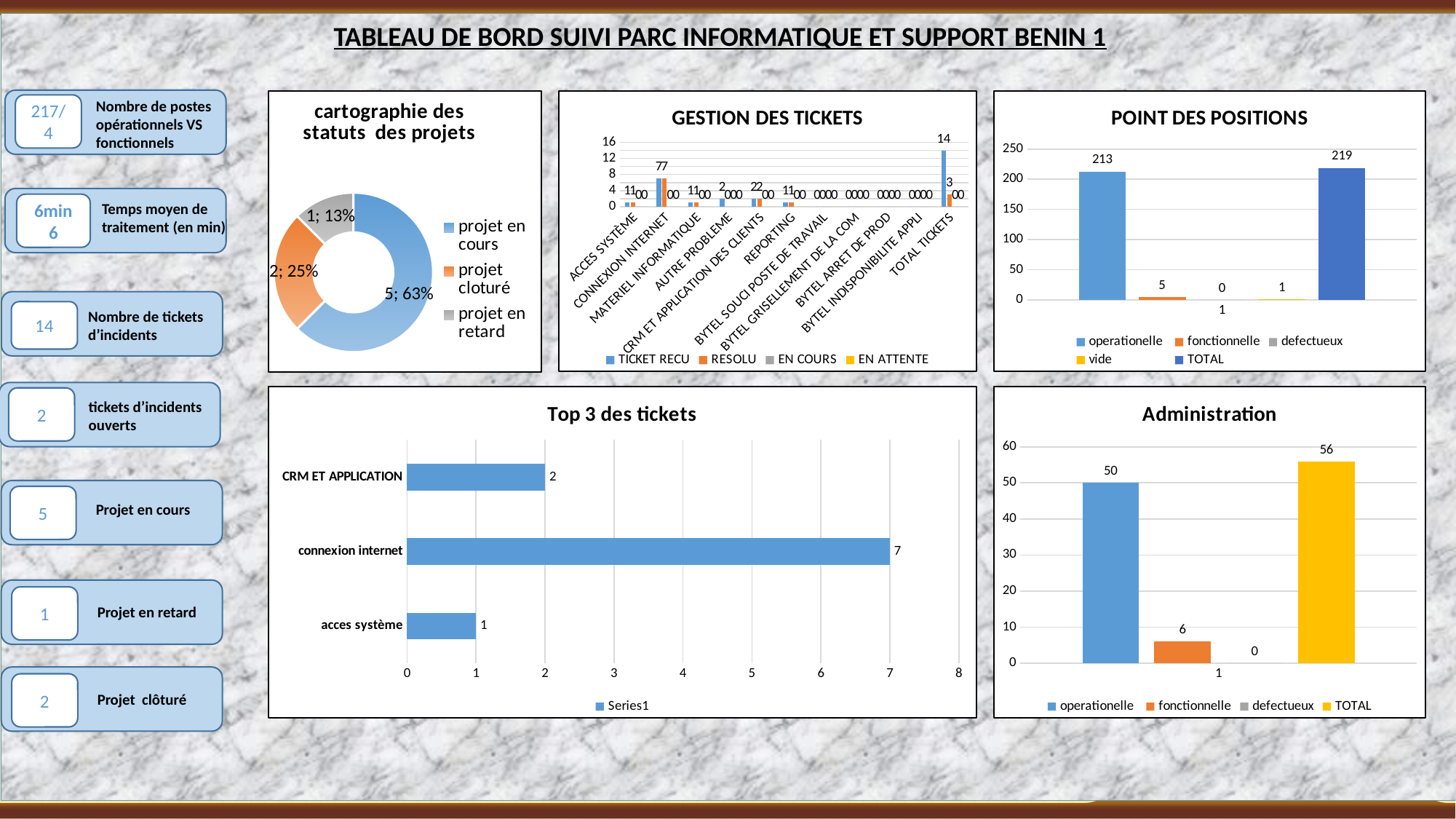
In the 'Administration' chart, which is larger, operationelle or fonctionnelle? operationelle In the 'Top 3 des tickets' chart, what is the difference between connexion internet and CRM ET APPLICATION? 5 How many slices does the 'cartographie des statuts des projets' doughnut chart have? 3 In the 'POINT DES POSITIONS' chart, what is the value for operationelle? 213 In the 'GESTION DES TICKETS' chart, what is the TICKET RECU value for TOTAL TICKETS? 14 In the 'Administration' chart, what is the value for fonctionnelle? 6 How many series does the legend of the 'POINT DES POSITIONS' chart list? 5 In the 'Top 3 des tickets' chart, what is the value for connexion internet? 7 In the 'POINT DES POSITIONS' chart, what is the value for TOTAL? 219 In the 'Top 3 des tickets' chart, which category has the lowest value? acces système In the 'cartographie des statuts des projets' chart, what share of the doughnut is 'projet en cours'? 63% What kind of chart is 'Top 3 des tickets'? bar chart